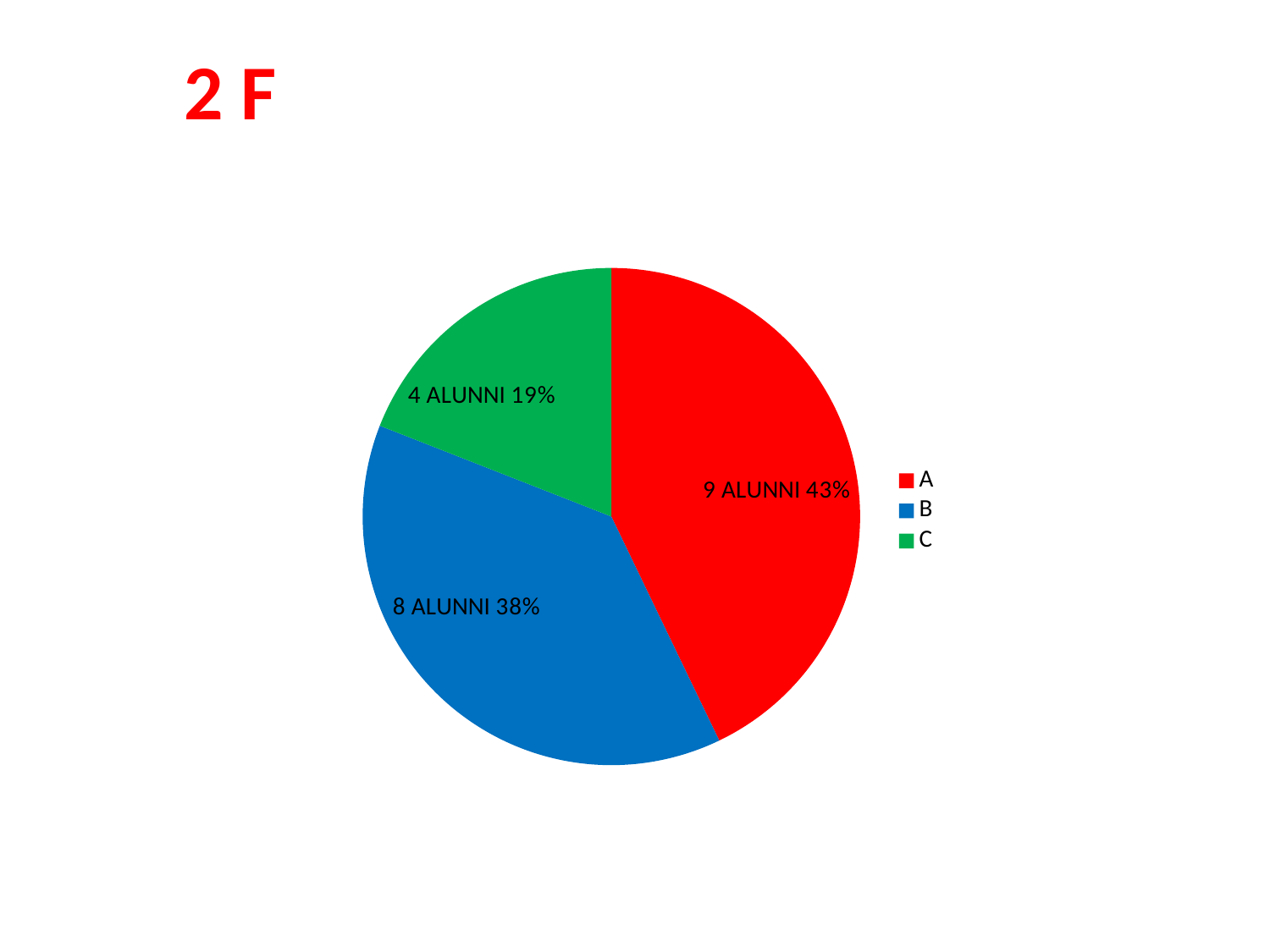
How many entries does the legend list? 3 What share of the pie does slice B represent? 38% What share of the pie does slice A represent? 43% Which category has the smallest slice? C How many alunni are in category A? 9 How many alunni are in category C? 4 What share of the pie does slice C represent? 19% What kind of chart is shown on the slide? pie chart How many slices does the pie chart have? 3 What is the difference in number of alunni between category A and category C? 5 How many alunni are in category B? 8 Which category has the largest slice? A